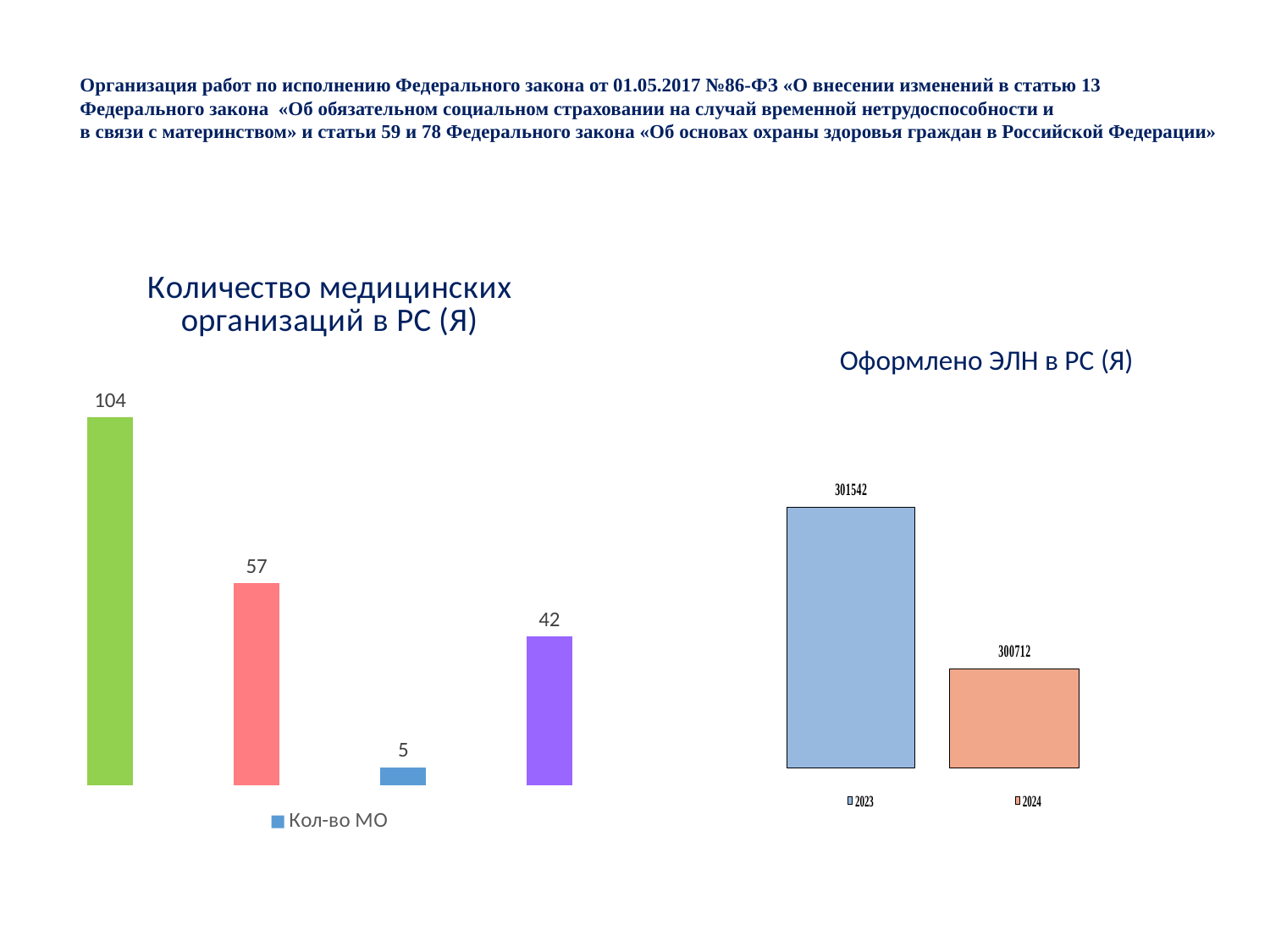
In the chart titled "Количество медицинских организаций в РС (Я)", what is the difference between the tallest and shortest bars? 99 In the chart titled "Оформлено ЭЛН в РС (Я)", do the values rise or fall from 2023 to 2024? fall In the chart titled "Оформлено ЭЛН в РС (Я)", which year has the higher value, 2023 or 2024? 2023 In the chart titled "Оформлено ЭЛН в РС (Я)", what is the difference between the 2023 and 2024 values? 830 In the chart titled "Количество медицинских организаций в РС (Я)", what is the value of the tallest bar? 104 In the chart titled "Оформлено ЭЛН в РС (Я)", what is the value for 2023? 301542 In the chart titled "Оформлено ЭЛН в РС (Я)", what is the value for 2024? 300712 What kind of chart is the one titled "Количество медицинских организаций в РС (Я)"? bar chart What is the legend entry shown below the chart titled "Количество медицинских организаций в РС (Я)"? Кол-во МО In the chart titled "Количество медицинских организаций в РС (Я)", how many bars are plotted? 4 In the chart titled "Количество медицинских организаций в РС (Я)", what is the value of the shortest bar? 5 In the chart titled "Оформлено ЭЛН в РС (Я)", how many bars are plotted? 2